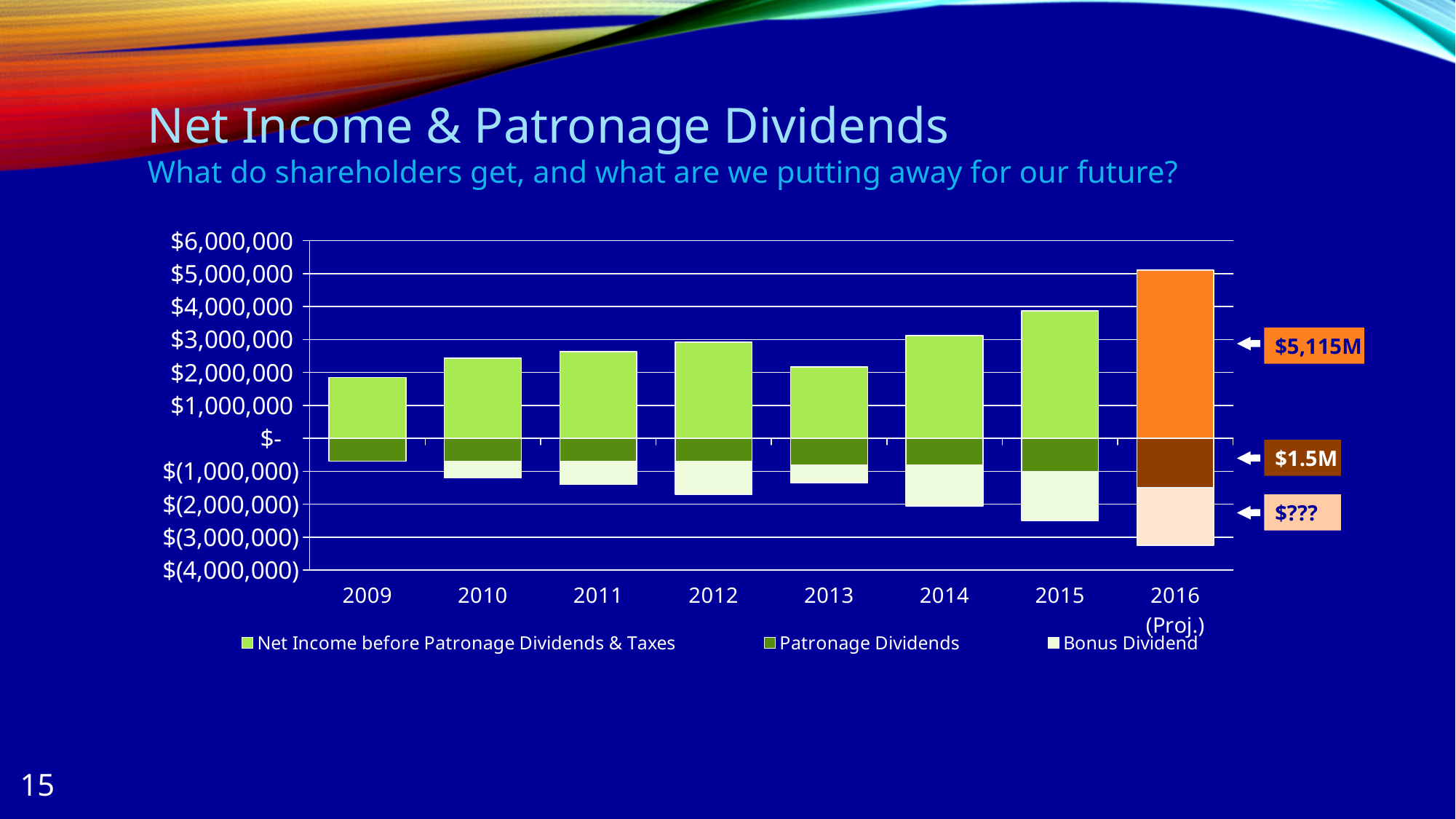
Which year has the larger Net Income before Patronage Dividends & Taxes, 2013 or 2014? 2014 Which year has the lowest Net Income before Patronage Dividends & Taxes? 2009 Does Net Income before Patronage Dividends & Taxes rise or fall from 2013 to 2016 (Proj.)? Rises Which year has the highest Net Income before Patronage Dividends & Taxes? 2016 (Proj.) Is the Net Income before Patronage Dividends & Taxes for 2015 greater or less than $3,000,000? greater What kind of chart is shown on the slide? Stacked bar chart How many years are shown on the x axis of the chart? 8 Is the Net Income before Patronage Dividends & Taxes for 2009 greater or less than $2,000,000? less What value is annotated for Patronage Dividends in 2016 (Proj.)? $1.5M What is the title of the chart slide? Net Income & Patronage Dividends What value is annotated for Net Income before Patronage Dividends & Taxes in 2016 (Proj.)? $5,115M How many series does the chart legend list? 3